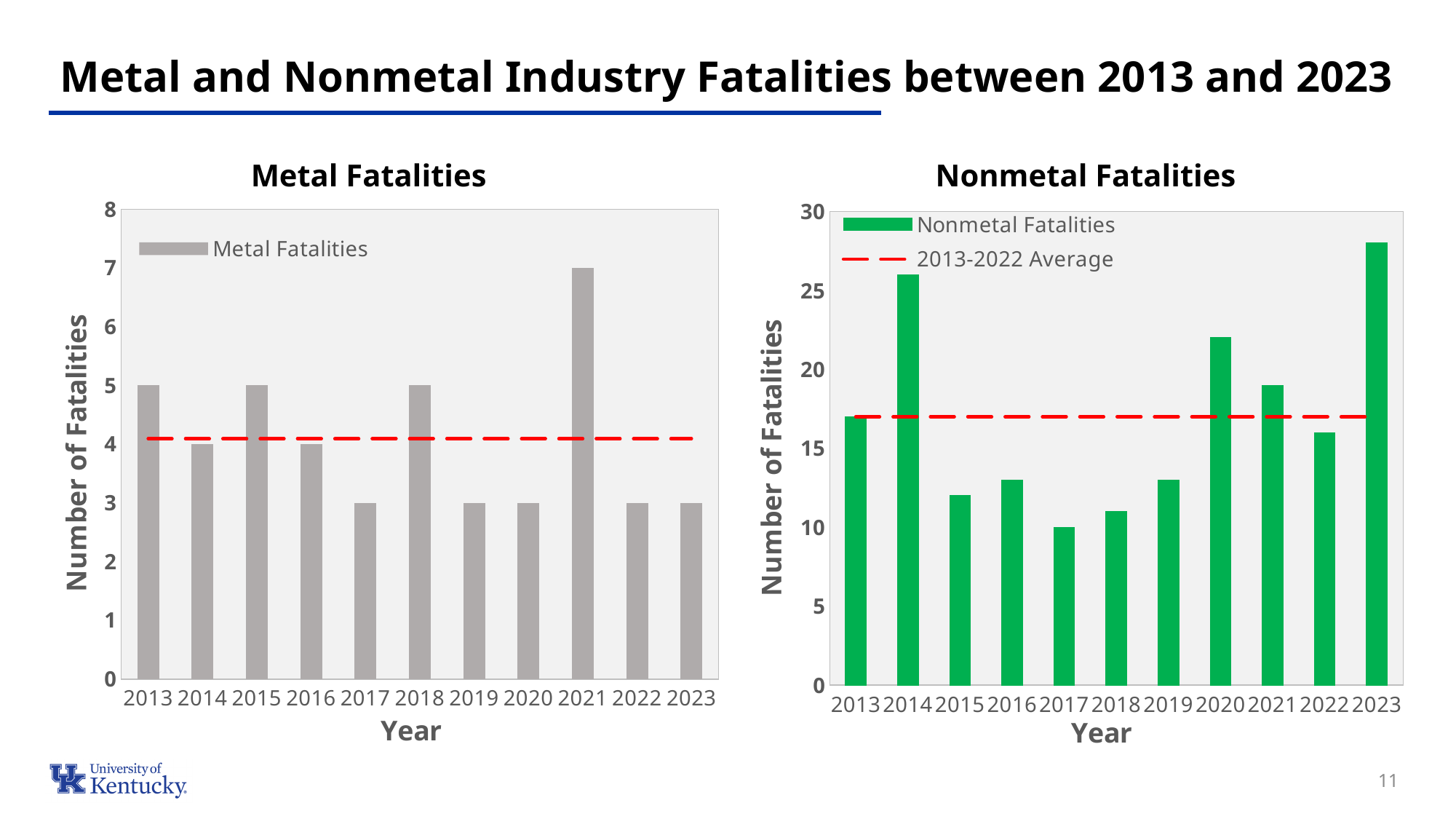
What kind of chart is the Metal Fatalities chart? Bar chart In the Nonmetal Fatalities chart, is the value for 2014 greater or less than 25? greater In the Nonmetal Fatalities chart, what is the number of fatalities in 2017? 10 In the Metal Fatalities chart, what is the number of fatalities in 2013? 5 In the Metal Fatalities chart, what is the difference between the fatalities in 2021 and 2022? 4 In the Metal Fatalities chart, what is the number of fatalities in 2021? 7 In the Metal Fatalities chart, which year has the highest number of fatalities? 2021 In the Nonmetal Fatalities chart, which year has the highest number of fatalities? 2023 In the Nonmetal Fatalities chart, which year has the lowest number of fatalities? 2017 In the Nonmetal Fatalities chart, how many entries does the legend list? 2 In the Nonmetal Fatalities chart, which year has more fatalities, 2020 or 2021? 2020 In the Metal Fatalities chart, how many years are shown on the x axis? 11